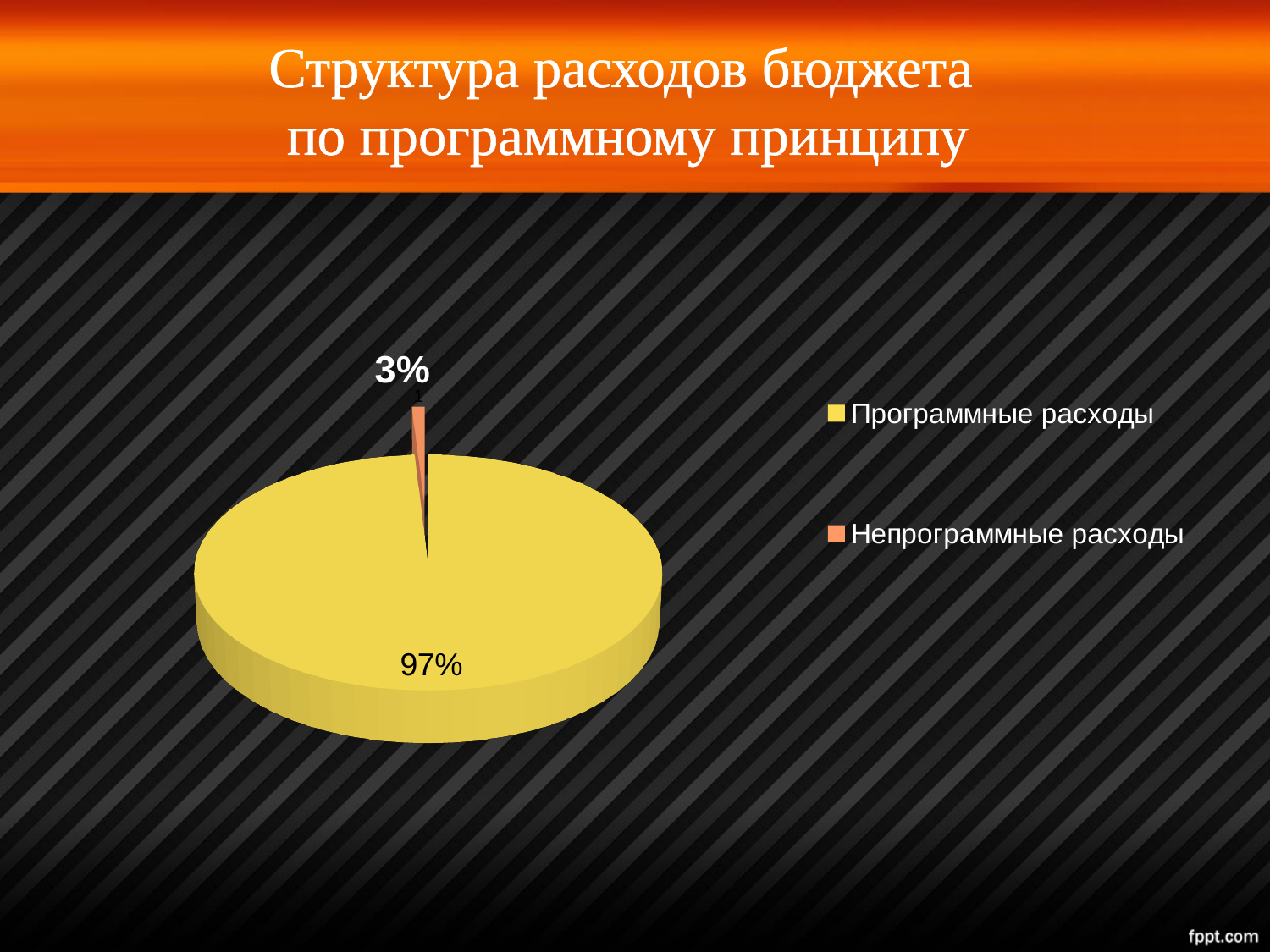
What is the title of the slide containing the chart? Структура расходов бюджета по программному принципу Which category has the smallest slice of the pie? Непрограммные расходы Which is larger, Программные расходы or Непрограммные расходы? Программные расходы What kind of chart is shown on the slide? pie chart Which category has the largest slice of the pie? Программные расходы How many entries does the legend list? 2 How many slices does the pie chart have? 2 What share of the pie does Программные расходы take? 97% What share of the pie does Непрограммные расходы take? 3% What colour is the slice for Непрограммные расходы? orange What is the difference in percentage points between Программные расходы and Непрограммные расходы? 94